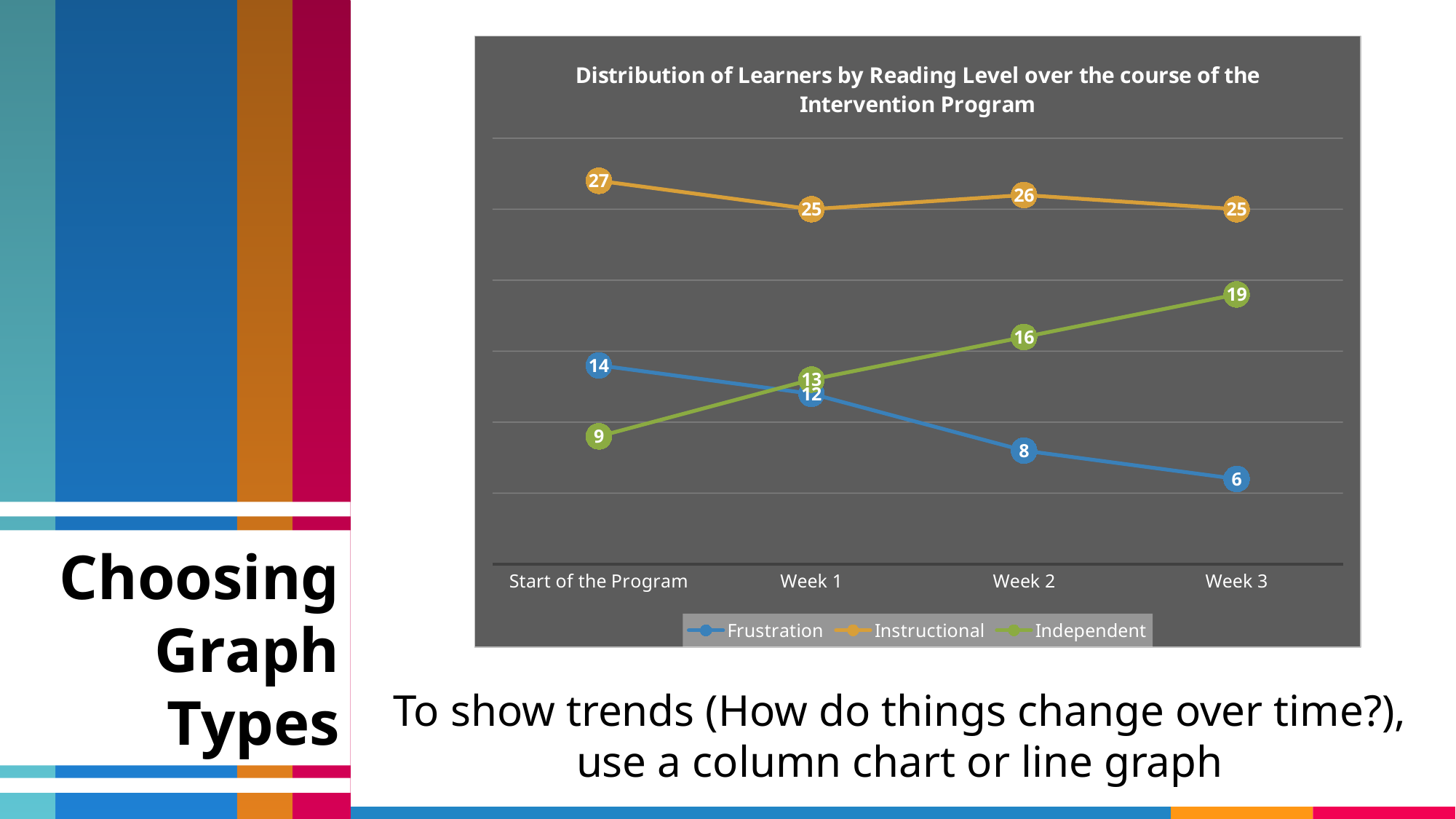
Which is larger at Week 1: Independent or Frustration? Independent How many series does the legend list? 3 What type of chart is shown on the slide? line chart What is the value for Instructional at the Start of the Program? 27 At which point is the Frustration series lowest? Week 3 What is the value for Independent at Week 3? 19 What is the value for Frustration at Week 2? 8 Does the Frustration series rise or fall from the Start of the Program to Week 3? fall What is the difference between the Independent and Frustration values at Week 3? 13 What is the title of the chart? Distribution of Learners by Reading Level over the course of the Intervention Program At which point is the Independent series highest? Week 3 How many points are on the x axis? 4